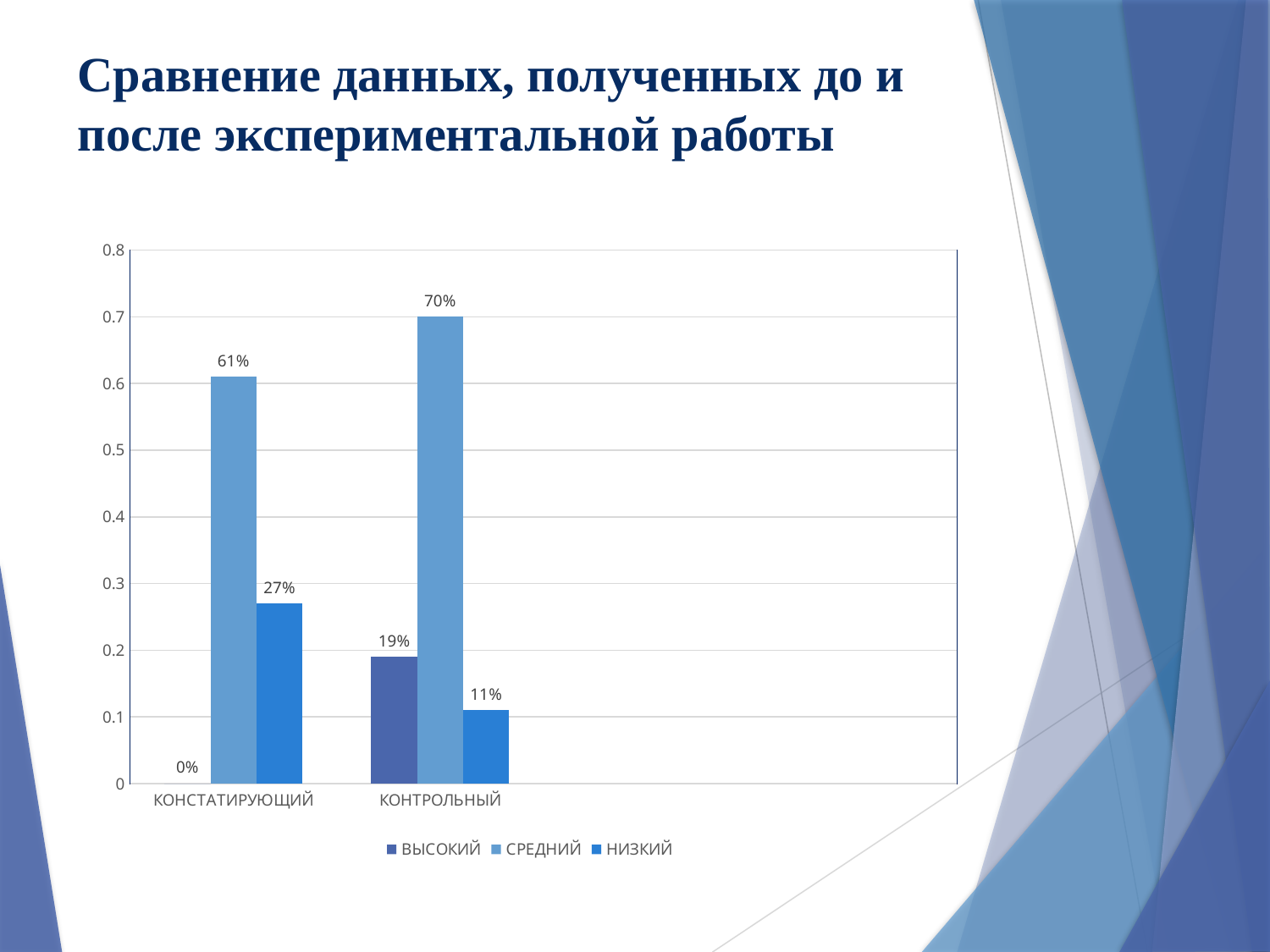
How many categories are shown on the x axis? 2 Which series has the highest value in the КОНТРОЛЬНЫЙ category? СРЕДНИЙ What is the value for ВЫСОКИЙ in the КОНТРОЛЬНЫЙ category? 19% Which series has the lowest value in the КОНСТАТИРУЮЩИЙ category? ВЫСОКИЙ How many series does the legend list? 3 Which is larger: НИЗКИЙ for КОНСТАТИРУЮЩИЙ or ВЫСОКИЙ for КОНТРОЛЬНЫЙ? НИЗКИЙ for КОНСТАТИРУЮЩИЙ What is the difference between the СРЕДНИЙ values for КОНТРОЛЬНЫЙ and КОНСТАТИРУЮЩИЙ? 9% What is the difference between the НИЗКИЙ values for КОНСТАТИРУЮЩИЙ and КОНТРОЛЬНЫЙ? 16% What is the value for СРЕДНИЙ in the КОНСТАТИРУЮЩИЙ category? 61% What is the value for ВЫСОКИЙ in the КОНСТАТИРУЮЩИЙ category? 0% What is the value for НИЗКИЙ in the КОНТРОЛЬНЫЙ category? 11% What kind of chart is shown on the slide? Bar chart